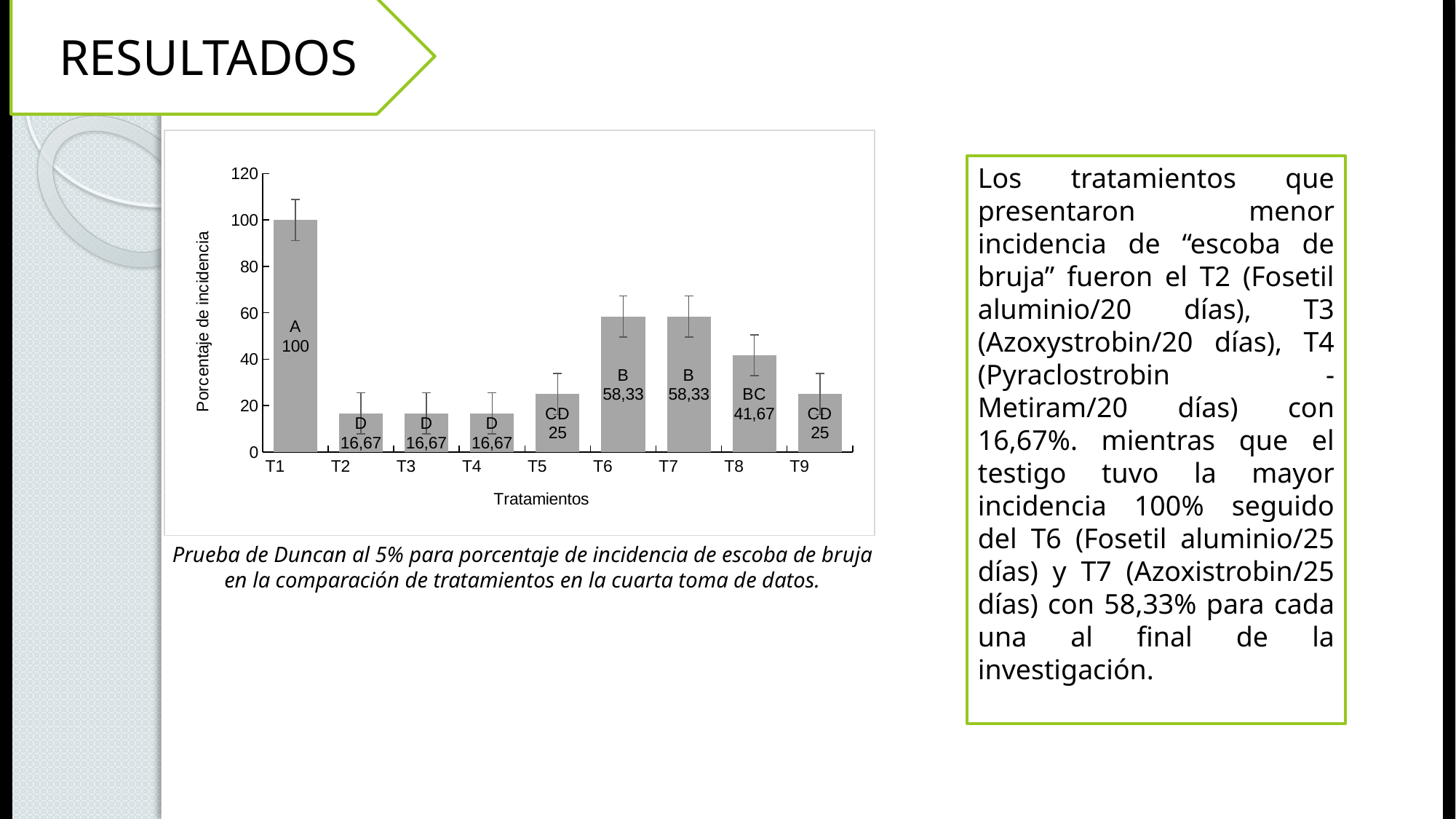
What is the value for T1? 100 How many treatments are shown on the x axis? 9 What is the value for T5? 25 What is the value for T6? 58,33 What is the value for T8? 41,67 Which treatment has the highest value? T1 What is the difference between the values for T1 and T8? 58,33 What is the label of the y axis? Porcentaje de incidencia What is the difference between the values for T6 and T5? 33,33 Which is larger, the value for T8 or the value for T9? T8 What kind of chart is shown on the slide? bar chart What is the lowest value shown in the chart? 16,67